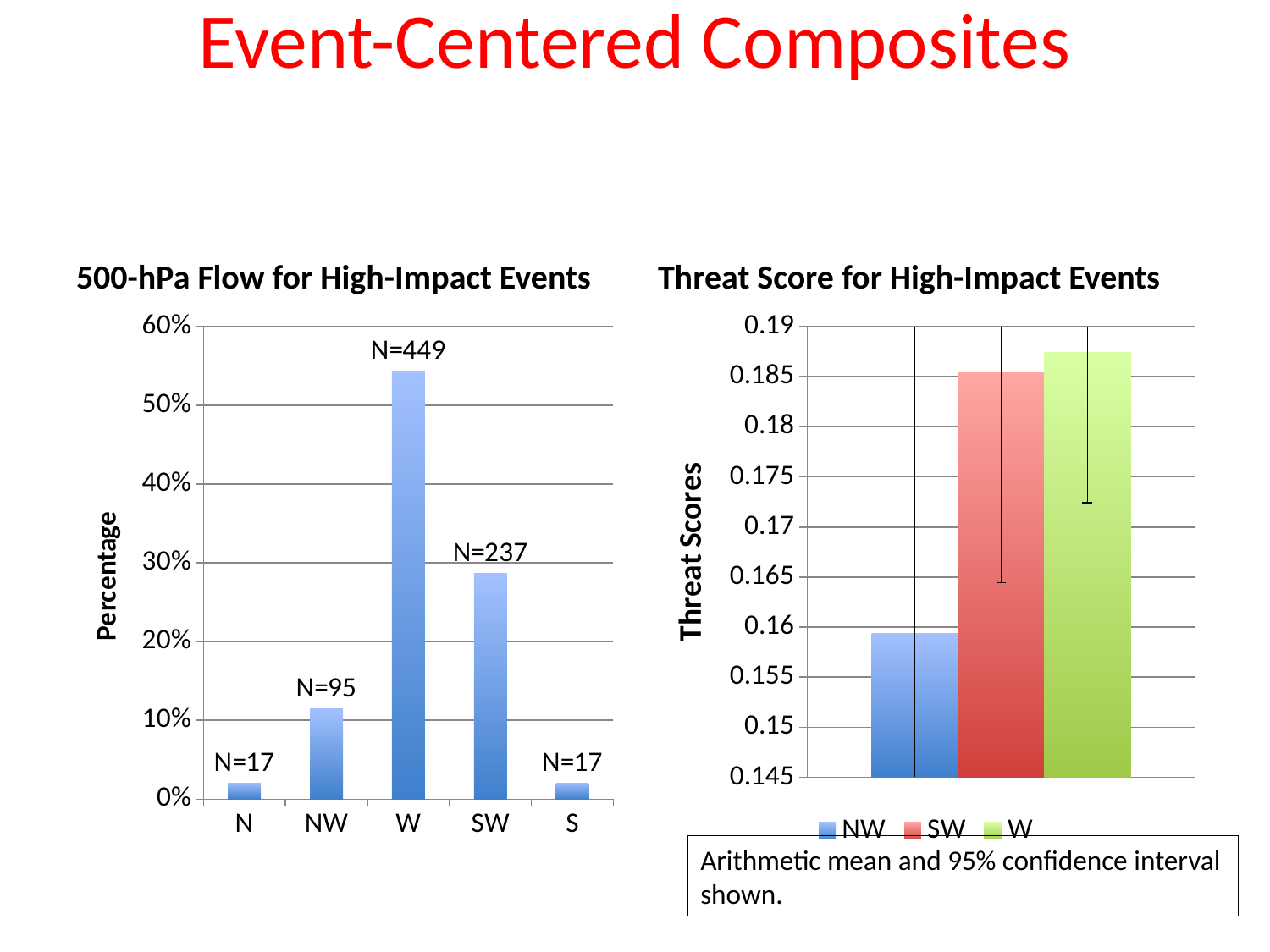
In the '500-hPa Flow for High-Impact Events' chart, which category has the highest percentage? W How many series does the legend of the 'Threat Score for High-Impact Events' chart list? 3 In the 'Threat Score for High-Impact Events' chart, which series has the lowest threat score? NW In the '500-hPa Flow for High-Impact Events' chart, what label is printed above the W bar? N=449 In the '500-hPa Flow for High-Impact Events' chart, is the value for SW greater or less than 30%? less How many categories are shown on the x axis of the '500-hPa Flow for High-Impact Events' chart? 5 What is the y-axis title of the 'Threat Score for High-Impact Events' chart? Threat Scores In the '500-hPa Flow for High-Impact Events' chart, is the value for W greater or less than 50%? greater What kind of chart is the '500-hPa Flow for High-Impact Events' chart? bar chart In the '500-hPa Flow for High-Impact Events' chart, which is larger, the value for NW or the value for SW? SW In the 'Threat Score for High-Impact Events' chart, is the value for NW greater or less than 0.16? less In the '500-hPa Flow for High-Impact Events' chart, what label is printed above the SW bar? N=237